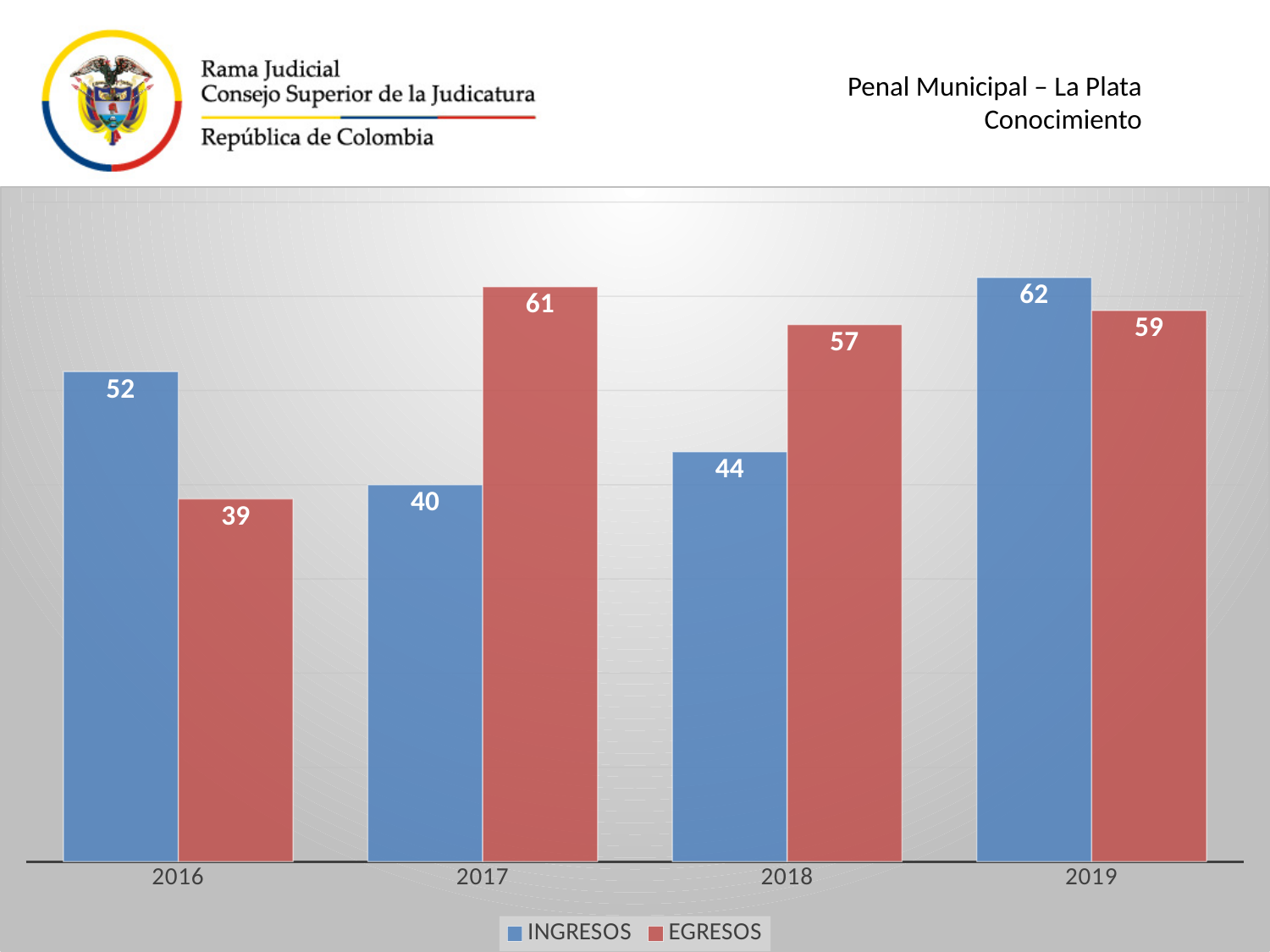
What is the difference between EGRESOS and INGRESOS in 2017? 21 What is the INGRESOS value for 2016? 52 What is the EGRESOS value for 2019? 59 What kind of chart is shown on the slide? bar chart How many years are shown on the x axis? 4 What is the INGRESOS value for 2018? 44 In 2018, which is larger, INGRESOS or EGRESOS? EGRESOS Which year has the lowest EGRESOS value? 2016 What is the EGRESOS value for 2017? 61 Which colour represents EGRESOS in the legend? red How many series does the legend list? 2 Which year has the highest INGRESOS value? 2019